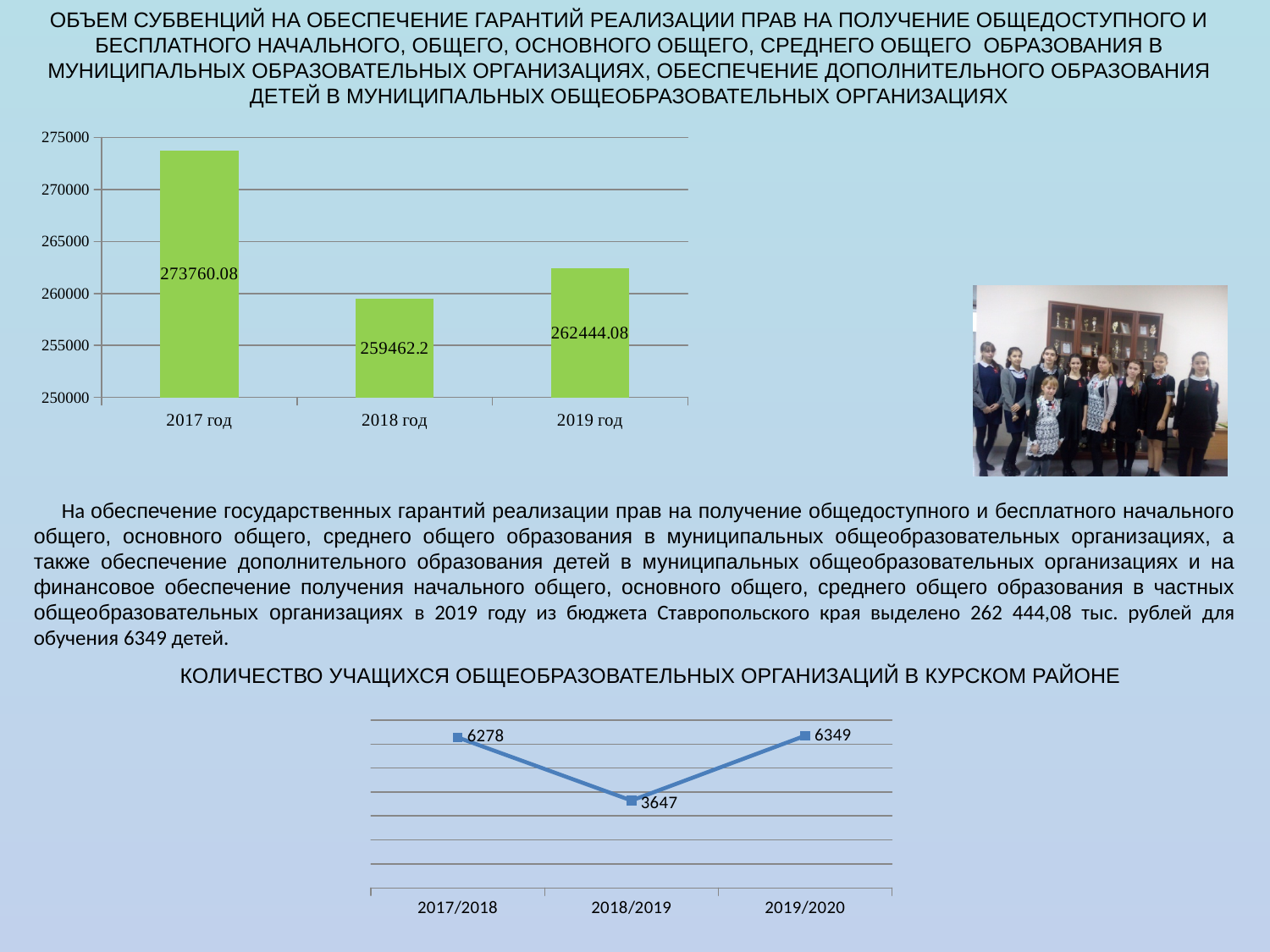
In the top bar chart, which year has the lowest value? 2018 год In the bottom line chart, which period has the highest value? 2019/2020 In the top bar chart, what is the value for 2018 год? 259462.2 In the bottom line chart, what is the difference between the values for 2019/2020 and 2017/2018? 71 In the bottom line chart, what is the value for 2019/2020? 6349 How many data points are plotted in the bottom line chart? 3 In the top bar chart, is the value for 2019 год greater or less than 260000? greater What kind of chart is the top chart on the slide? bar chart In the bottom line chart, what is the value for 2018/2019? 3647 In the top bar chart, what is the difference between the values for 2017 год and 2019 год? 11316 In the top bar chart, which year has the highest value? 2017 год In the top bar chart, what is the value for 2017 год? 273760.08